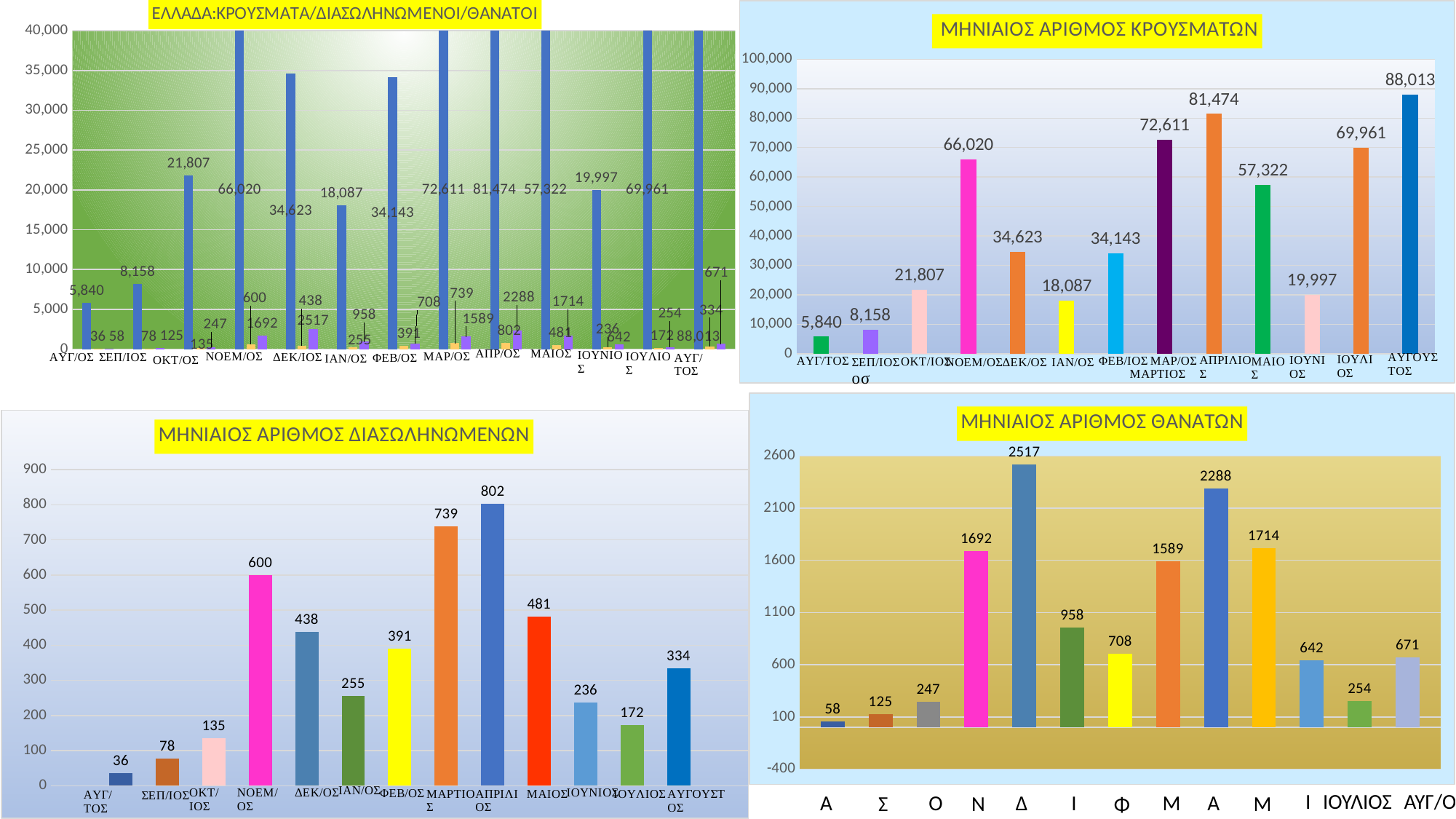
In the top-left chart titled ΕΛΛΑΔΑ:ΚΡΟΥΣΜΑΤΑ/ΔΙΑΣΩΛΗΝΩΜΕΝΟΙ/ΘΑΝΑΤΟΙ, what is the value of the tallest bar for ΟΚΤ/ΟΣ? 21,807 In the chart titled ΜΗΝΙΑΙΟΣ ΑΡΙΘΜΟΣ ΚΡΟΥΣΜΑΤΩΝ, what is the value for ΑΥΓΟΥΣΤΟΣ? 88,013 In the chart titled ΜΗΝΙΑΙΟΣ ΑΡΙΘΜΟΣ ΘΑΝΑΤΩΝ, what is the highest value shown? 2517 In the chart titled ΜΗΝΙΑΙΟΣ ΑΡΙΘΜΟΣ ΘΑΝΑΤΩΝ, what is the value for ΙΟΥΛΙΟΣ? 254 In the chart titled ΜΗΝΙΑΙΟΣ ΑΡΙΘΜΟΣ ΚΡΟΥΣΜΑΤΩΝ, what is the difference between the values for ΑΠΡΙΛΙΟΣ and ΜΑΡΤΙΟΣ? 8,863 In the chart titled ΜΗΝΙΑΙΟΣ ΑΡΙΘΜΟΣ ΔΙΑΣΩΛΗΝΩΜΕΝΩΝ, what is the difference between the values for ΜΑΡΤΙΟΣ and ΜΑΙΟΣ? 258 In the chart titled ΜΗΝΙΑΙΟΣ ΑΡΙΘΜΟΣ ΚΡΟΥΣΜΑΤΩΝ, how many bars are plotted? 13 In the chart titled ΜΗΝΙΑΙΟΣ ΑΡΙΘΜΟΣ ΚΡΟΥΣΜΑΤΩΝ, which month has the lowest value? ΑΥΓ/ΤΟΣ In the chart titled ΜΗΝΙΑΙΟΣ ΑΡΙΘΜΟΣ ΔΙΑΣΩΛΗΝΩΜΕΝΩΝ, what is the value for ΝΟΕΜ/ΟΣ? 600 In the chart titled ΜΗΝΙΑΙΟΣ ΑΡΙΘΜΟΣ ΔΙΑΣΩΛΗΝΩΜΕΝΩΝ, which is larger, the value for ΔΕΚ/ΟΣ or the value for ΦΕΒ/ΟΣ? ΔΕΚ/ΟΣ In the chart titled ΜΗΝΙΑΙΟΣ ΑΡΙΘΜΟΣ ΔΙΑΣΩΛΗΝΩΜΕΝΩΝ, which month has the highest value? ΑΠΡΙΛΙΟΣ What kind of chart is the one titled ΜΗΝΙΑΙΟΣ ΑΡΙΘΜΟΣ ΘΑΝΑΤΩΝ? Bar chart